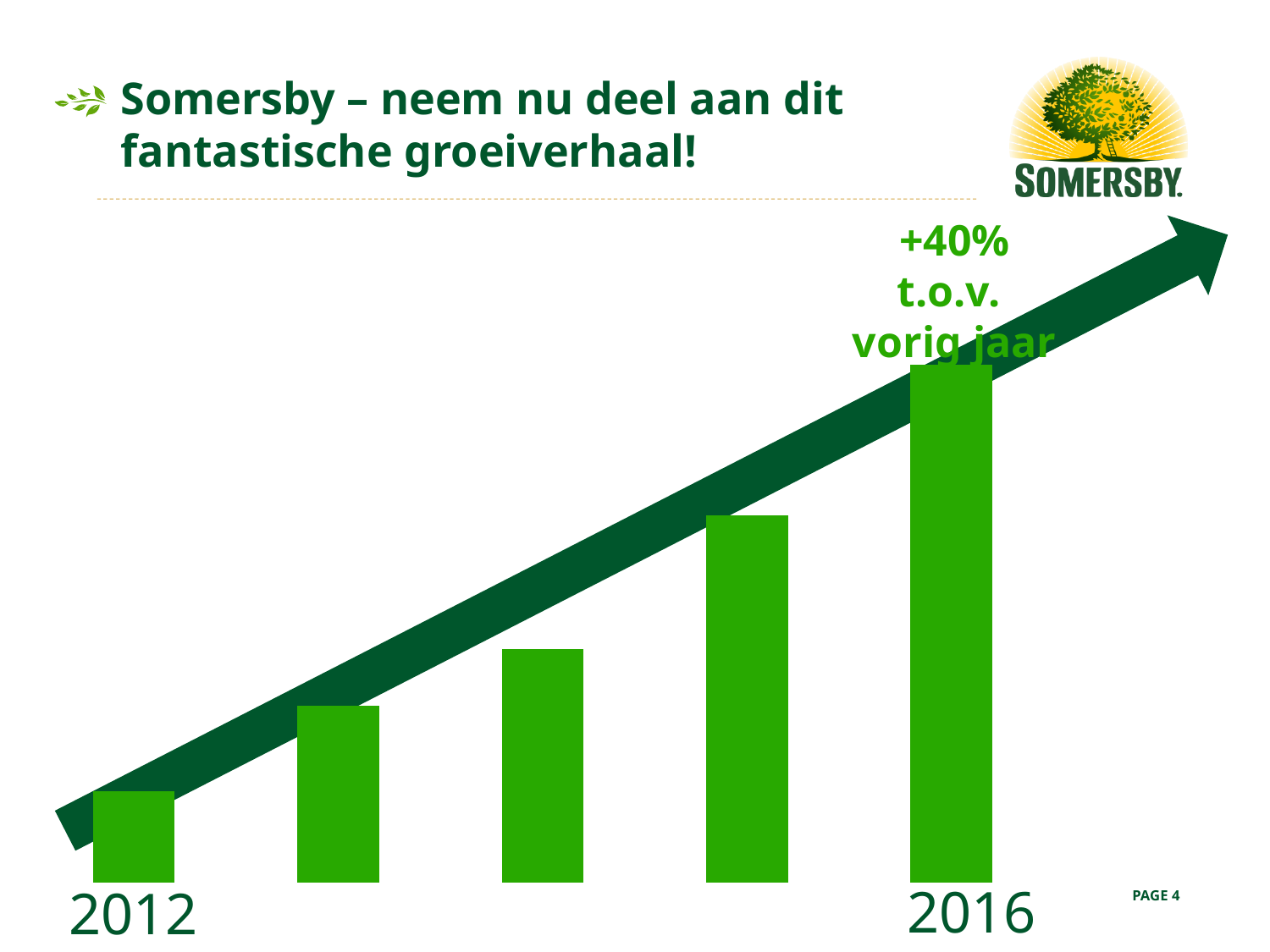
Which year has the shortest bar in the chart? 2012 What is the last year labelled on the x axis of the chart? 2016 Do the bar values rise or fall from 2012 to 2016? rise What kind of chart is shown on the slide? bar chart How many bars are plotted in the chart? 5 Is the bar for 2016 taller than the bar for 2015 (the fourth bar)? yes Which bar is taller, the one for 2012 or the one for 2016? 2016 What growth percentage is annotated above the 2016 bar? +40% What is the first year labelled on the x axis of the chart? 2012 Which year has the tallest bar in the chart? 2016